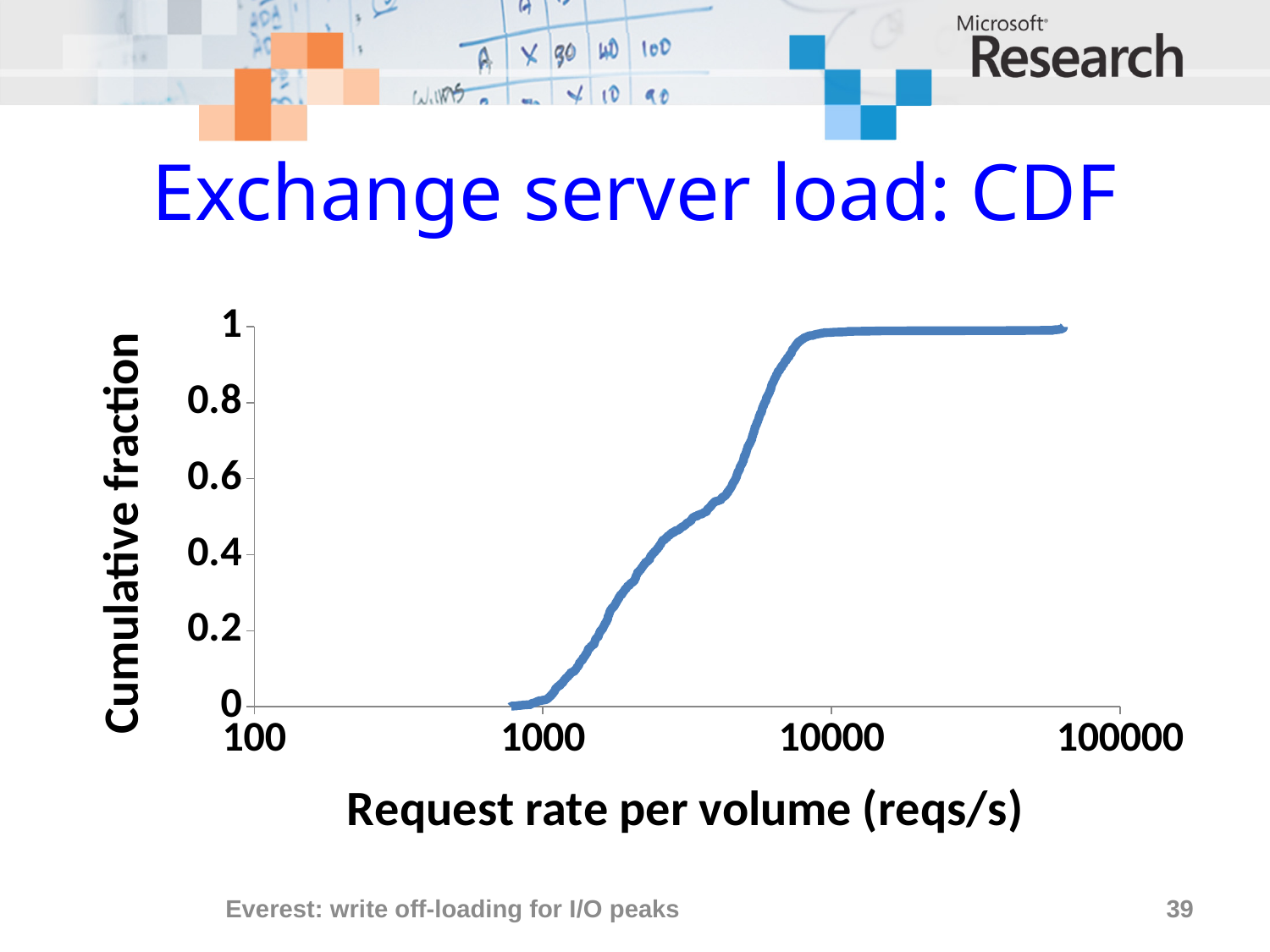
Which is larger: the cumulative fraction at 1000 reqs/s or at 10000 reqs/s? 10000 reqs/s What is the label of the x axis? Request rate per volume (reqs/s) Is the cumulative fraction at a request rate of 5000 reqs/s greater or less than 0.4? greater Does the cumulative fraction rise or fall as the request rate per volume increases? rise Is the cumulative fraction at a request rate of 1000 reqs/s greater or less than 0.2? less What is the title of the chart on the slide? Exchange server load: CDF Is the cumulative fraction at a request rate of 2000 reqs/s greater or less than 0.6? less What kind of chart is shown on the slide? line chart How many lines are plotted on the chart? 1